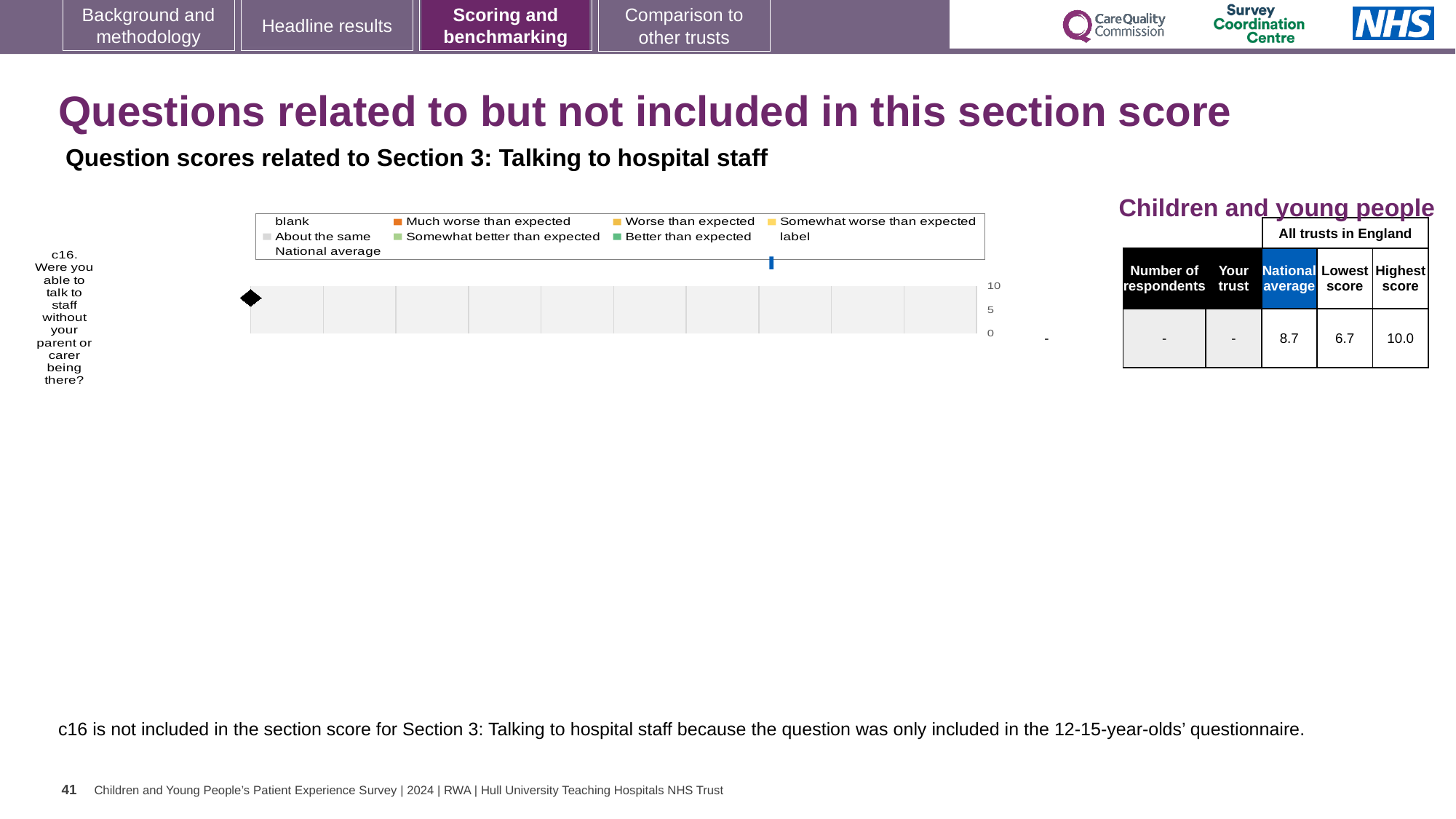
What is the highest value shown on the chart's horizontal axis? 10 How many question categories are shown on the chart's vertical axis? 1 Does the chart show any plotted bar for question c16? No Which question number is labelled on the chart's category axis? c16